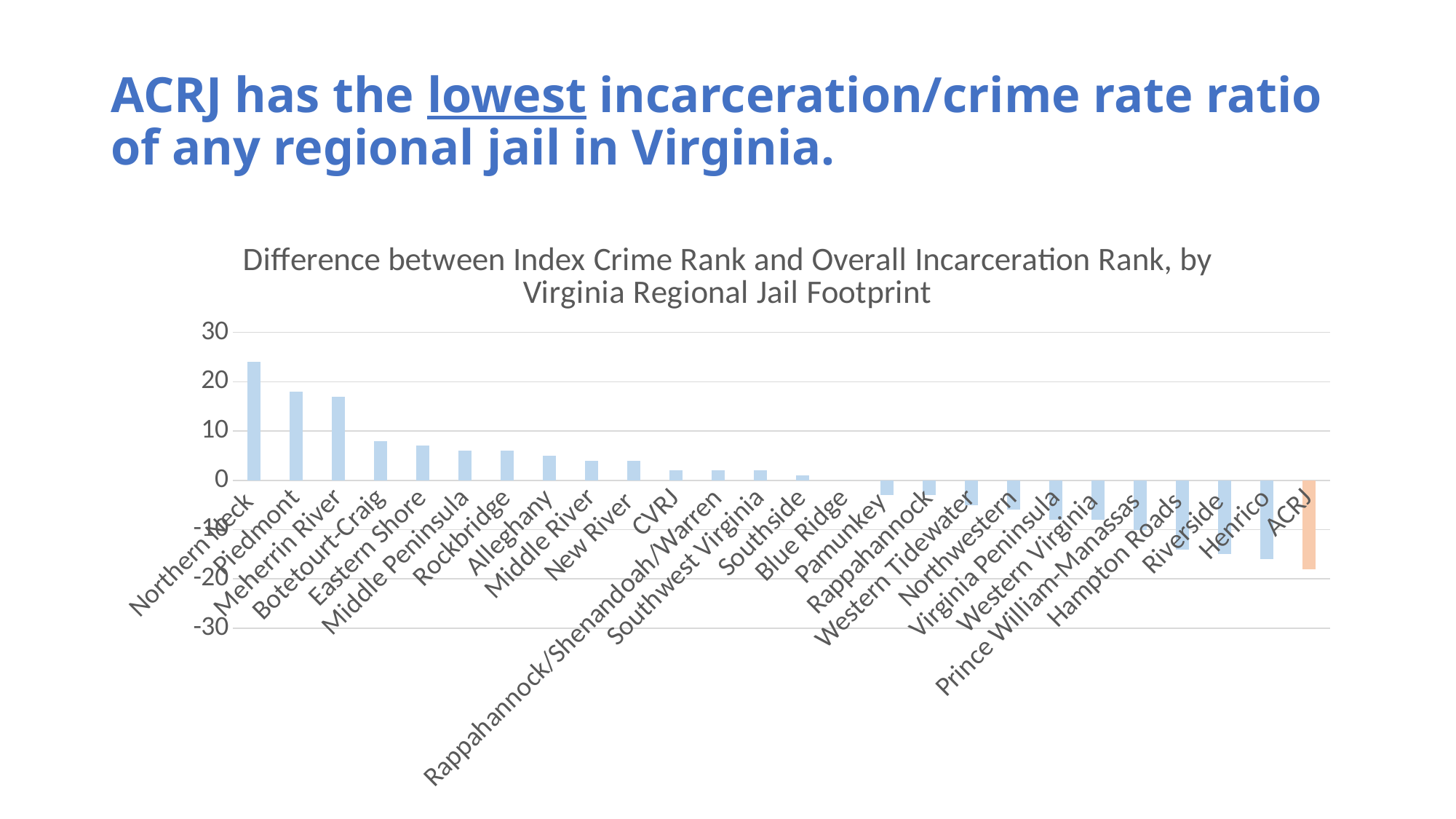
Which regional jail has the lowest value in the chart? ACRJ Which bar is shown in a different colour (orange) from the rest? ACRJ What kind of chart is shown on the slide? bar chart Which regional jail has the highest value in the chart? Northern Neck Do the values rise or fall moving from left to right along the x axis? fall Which has the larger value, Meherrin River or Eastern Shore? Meherrin River Is the value for Pamunkey greater or less than -10? greater Is the value for Northern Neck greater or less than 20? greater Is the value for ACRJ greater or less than -10? less How many regional jails are plotted in the chart? 26